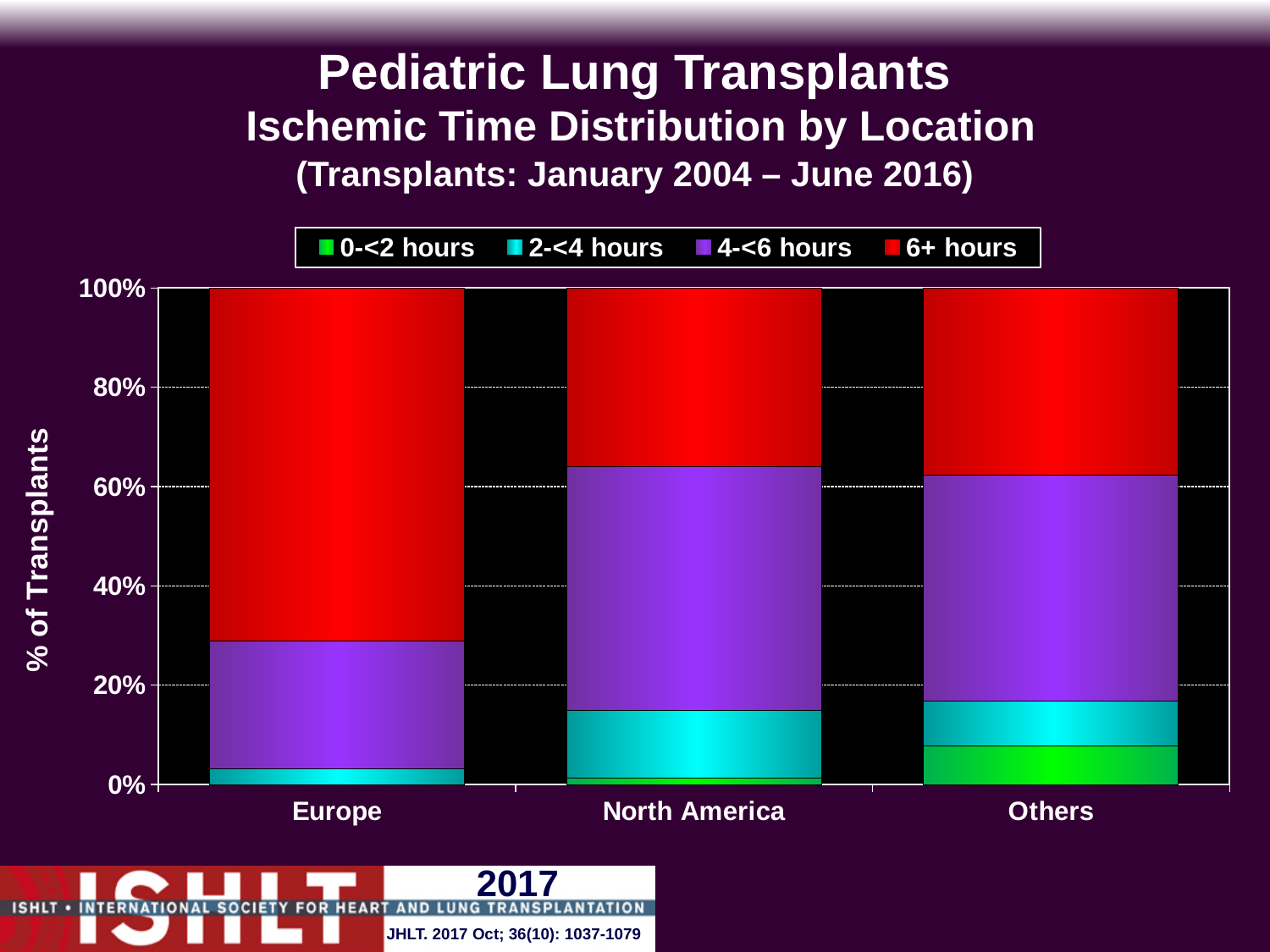
Which is larger: the 6+ hours share for Europe or the 6+ hours share for North America? Europe How many locations are shown on the x axis of the chart? 3 Is the 0-<2 hours share for Others greater or less than 20%? less Is the 6+ hours share for Europe greater or less than 60%? greater Is the 4-<6 hours share for North America greater or less than 40%? greater Which location has the largest share of transplants with an ischemic time of 6+ hours? Europe How many series does the legend list? 4 Which legend entry is shown in red? 6+ hours What is the label of the y axis? % of Transplants Which location has the largest share of transplants with an ischemic time of 0-<2 hours? Others What kind of chart is shown on the slide? Stacked bar chart